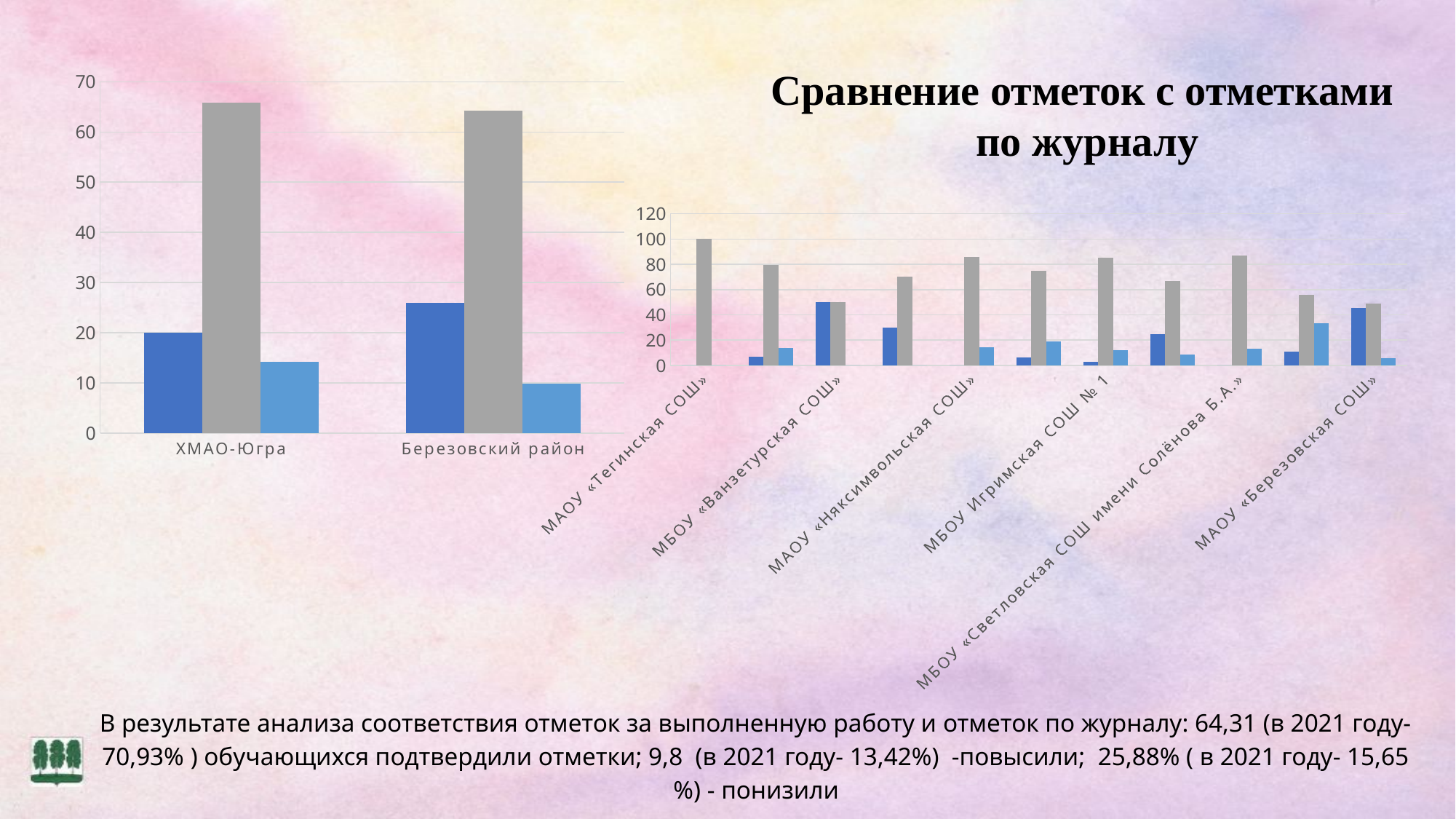
What is the title of the chart on the right of the slide? Сравнение отметок с отметками по журналу How many categories are shown on the x axis of the left chart? 2 In the chart titled «Сравнение отметок с отметками по журналу», what is the highest value shown on the vertical axis? 120 In the left chart, which category has the taller light blue bar, ХМАО-Югра or Березовский район? ХМАО-Югра In the left chart, is the dark blue bar for Березовский район greater or less than 20? greater In the left chart, is the gray bar for ХМАО-Югра greater or less than 60? greater In the left chart, which category has the taller dark blue bar, ХМАО-Югра or Березовский район? Березовский район What kind of chart is the chart on the left of the slide? bar chart In the chart titled «Сравнение отметок с отметками по журналу», which labelled school has the tallest gray bar? МАОУ «Тегинская СОШ» In the left chart, is the gray bar for Березовский район greater or less than 60? greater